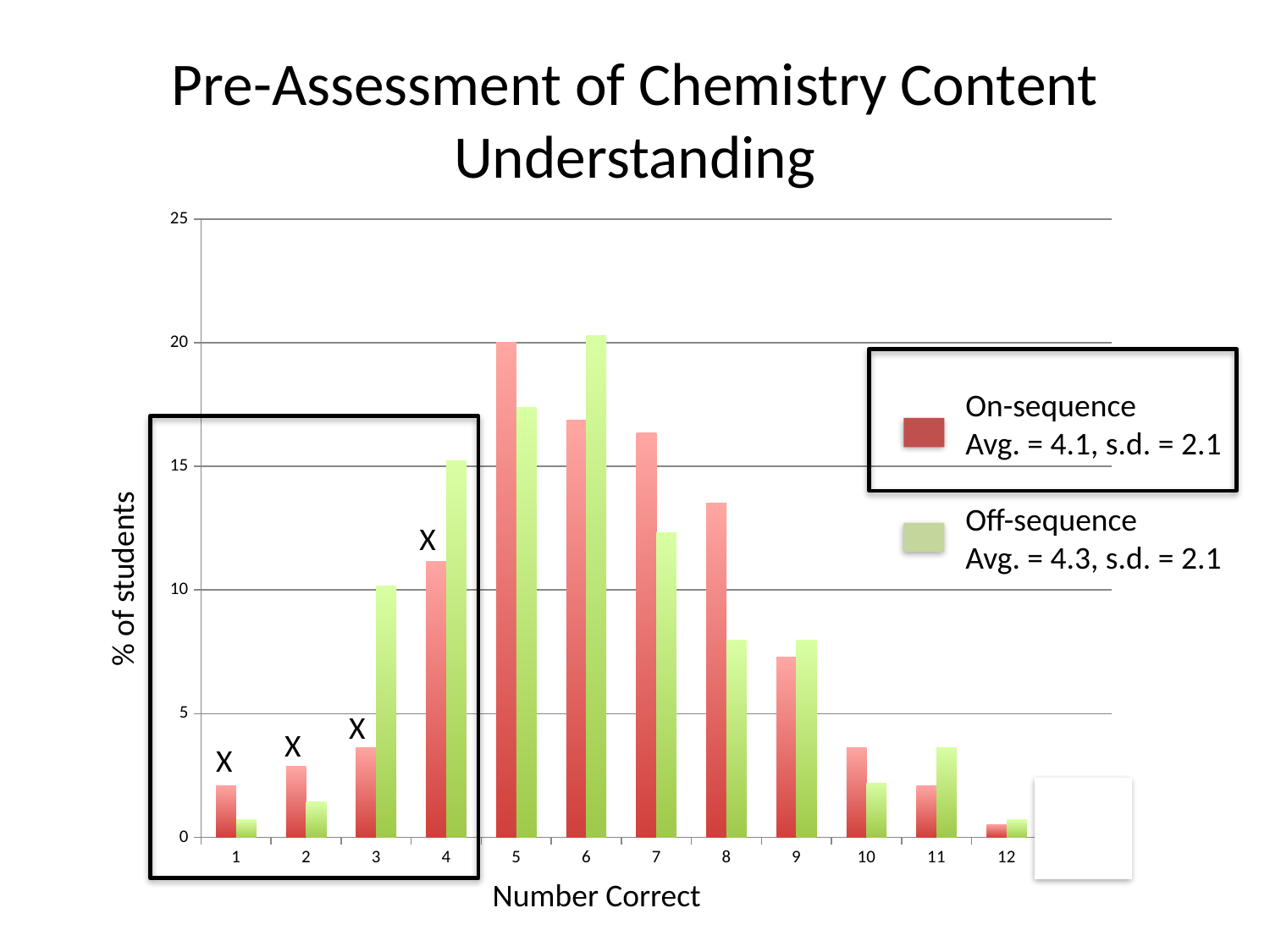
For which Number Correct value is the Off-sequence bar highest? 6 Is the On-sequence value for Number Correct 8 greater or less than 10? greater At Number Correct 3, which series has the larger value, On-sequence or Off-sequence? Off-sequence For which Number Correct value is the On-sequence bar highest? 5 What kind of chart is shown on the slide? bar chart How many series does the legend list? 2 How many Number Correct categories are shown on the x axis? 12 According to the legend, what is the average for the On-sequence group? 4.1 Is the Off-sequence value for Number Correct 11 greater or less than 5? less At Number Correct 7, which series has the larger value, On-sequence or Off-sequence? On-sequence For which Number Correct value is the On-sequence bar lowest? 12 Is the On-sequence value for Number Correct 7 greater or less than 15? greater